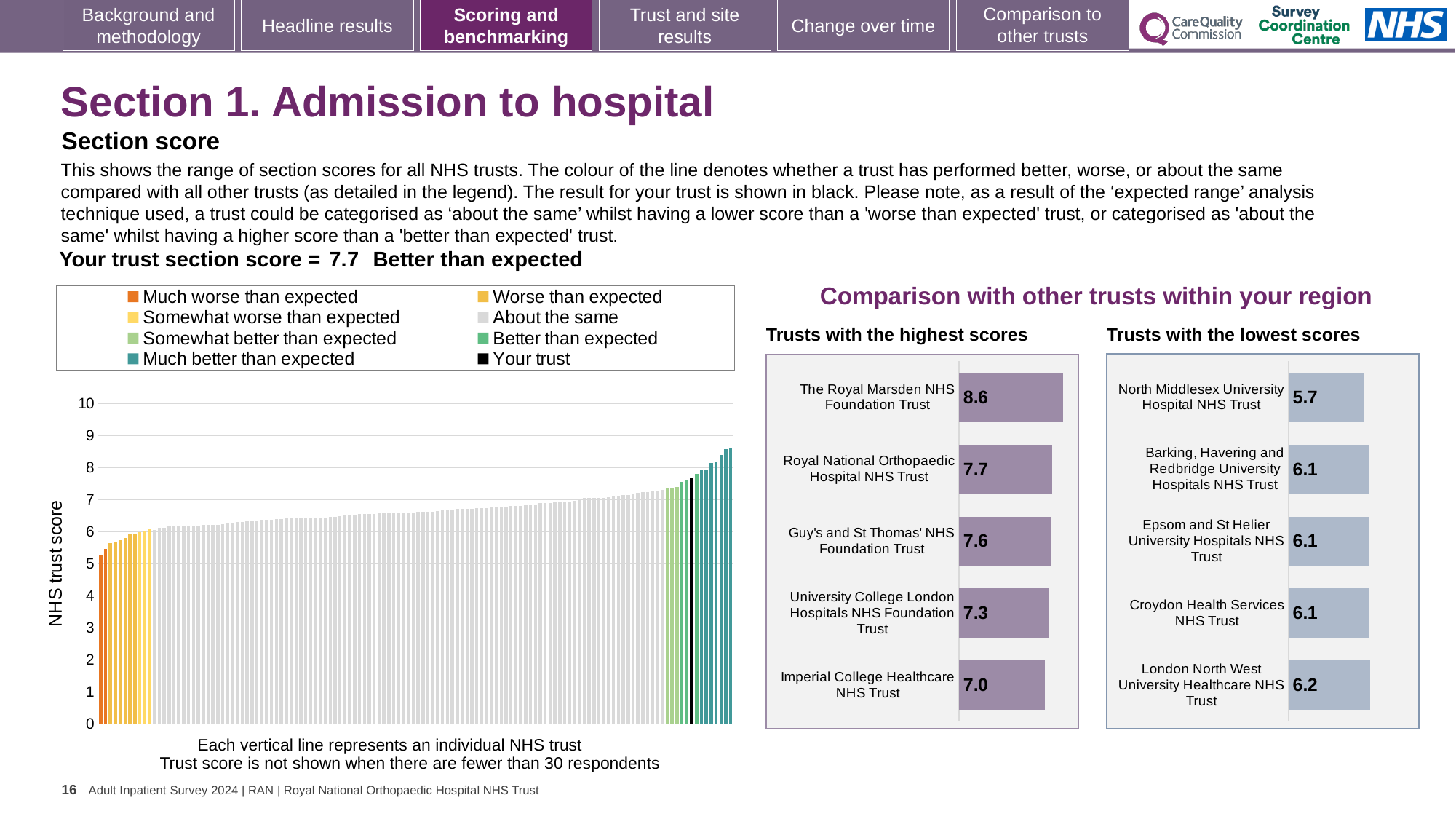
In the 'Trusts with the highest scores' chart, what is the score for Imperial College Healthcare NHS Trust? 7.0 In the 'Trusts with the lowest scores' chart, which trust has the highest score? London North West University Healthcare NHS Trust In the large chart on the left, do the NHS trust scores rise or fall from left to right? Rise What type of chart is the large chart on the left showing NHS trust scores? Bar chart In the 'Trusts with the highest scores' chart, which trust has the lowest score? Imperial College Healthcare NHS Trust In the 'Trusts with the highest scores' chart, what is the difference between the scores of The Royal Marsden NHS Foundation Trust and Royal National Orthopaedic Hospital NHS Trust? 0.9 How many trusts are shown in the 'Trusts with the lowest scores' chart? 5 In the 'Trusts with the highest scores' chart, what is the score for The Royal Marsden NHS Foundation Trust? 8.6 In the 'Trusts with the lowest scores' chart, what is the difference between the scores of London North West University Healthcare NHS Trust and North Middlesex University Hospital NHS Trust? 0.5 In the large chart on the left, is the value of the leftmost (lowest) bar greater or less than 6? less In the 'Trusts with the lowest scores' chart, what is the score for North Middlesex University Hospital NHS Trust? 5.7 In the 'Trusts with the highest scores' chart, which has a higher score: Guy's and St Thomas' NHS Foundation Trust or University College London Hospitals NHS Foundation Trust? Guy's and St Thomas' NHS Foundation Trust